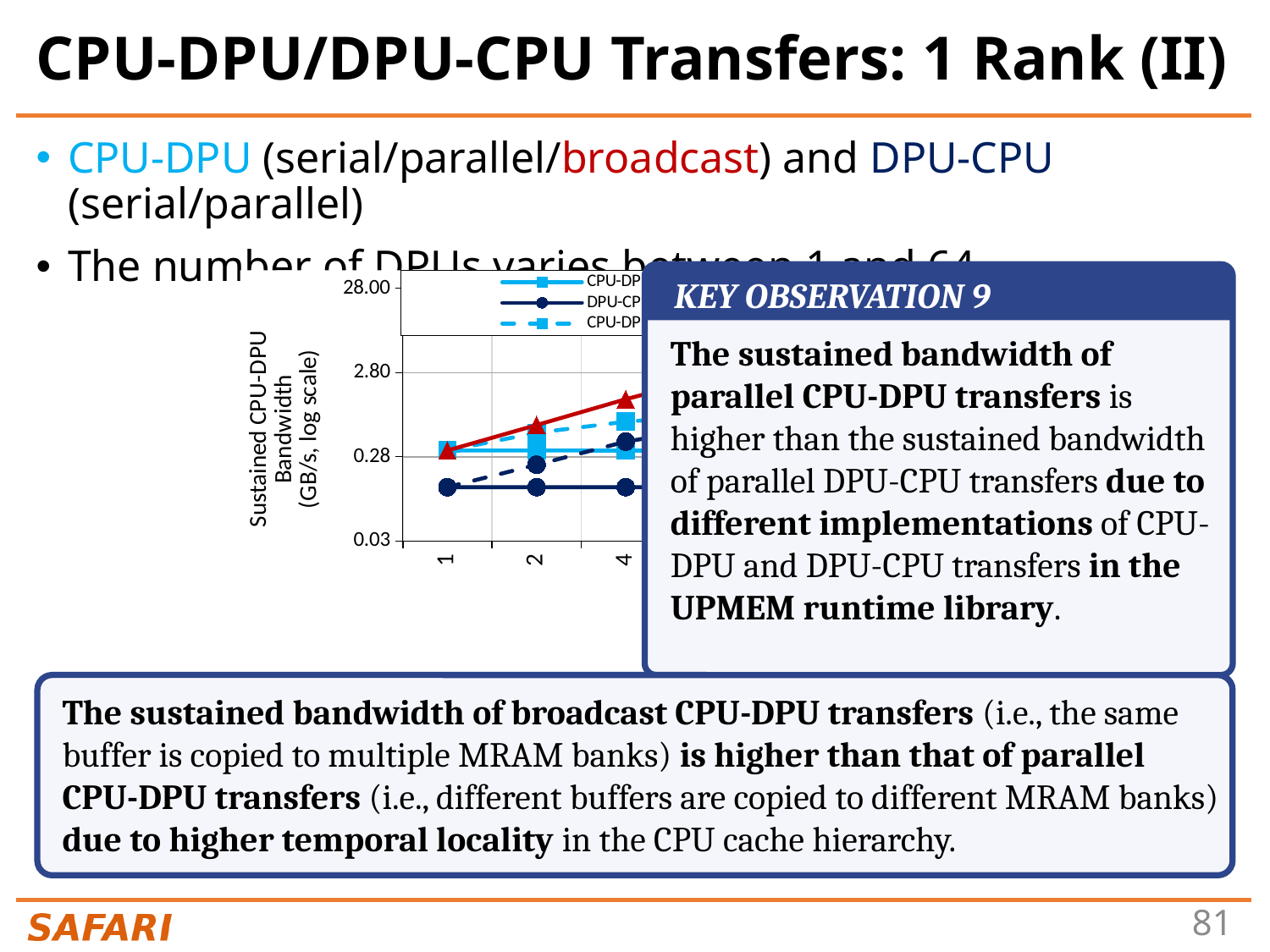
Is the value of the dark blue solid line with circle markers at 1 DPU greater or less than 0.28? less What is the label of the y-axis of the chart? Sustained CPU-DPU Bandwidth (GB/s, log scale) Does the red line with triangle markers rise or fall as the number of DPUs increases from 1 to 4? rise What is the highest tick value shown on the y-axis of the chart? 28.00 What kind of chart is shown on the slide? line chart Is the value of the red line with triangle markers at 4 DPUs greater or less than 0.28? greater Is the value of the red line with triangle markers at 4 DPUs greater or less than 2.80? less